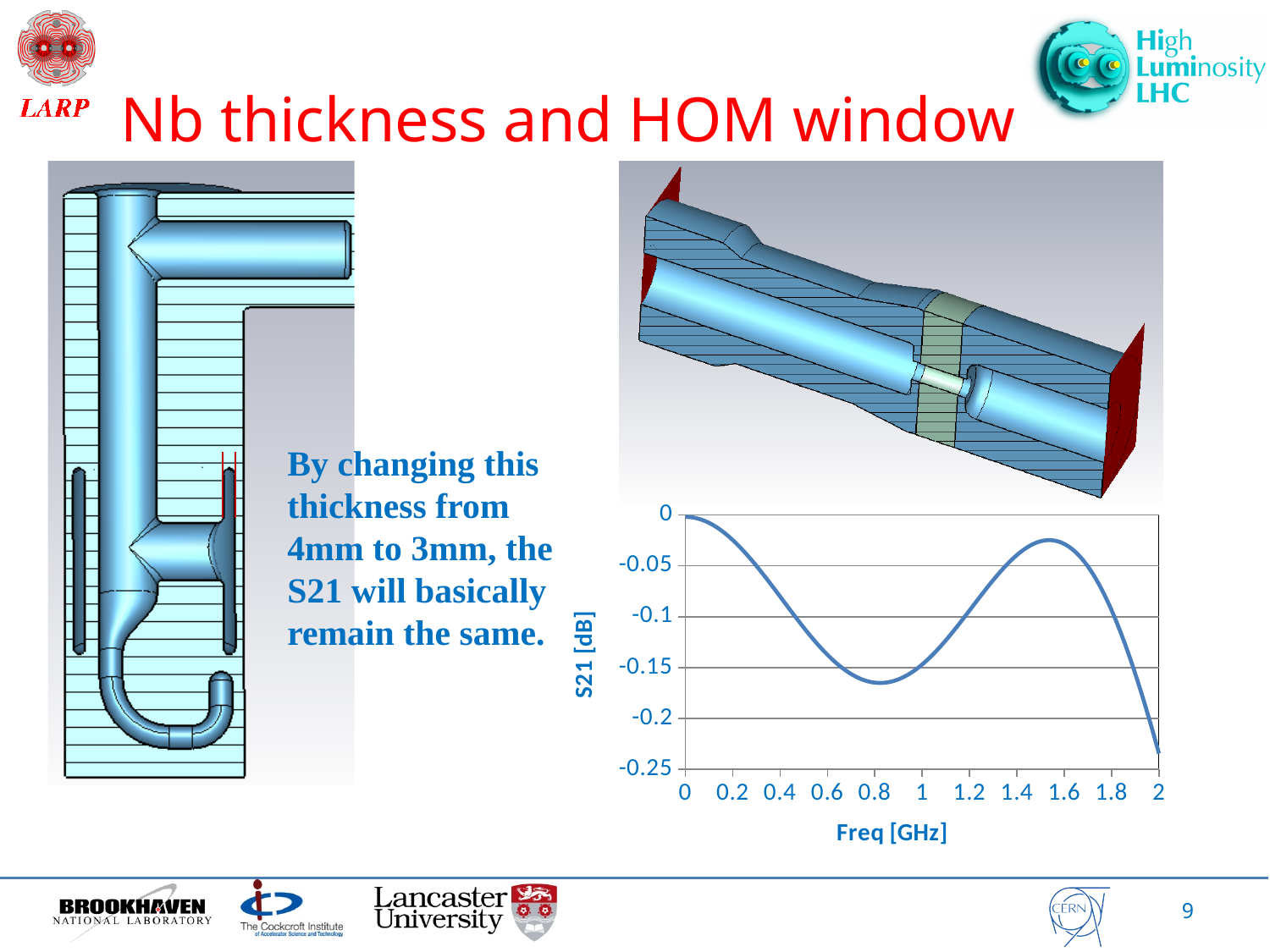
What kind of chart is shown on the slide? line chart Is the S21 value at 2 GHz greater or less than -0.2? less Is the S21 value at 1.2 GHz greater or less than -0.15? greater Does the S21 curve rise or fall between 0.8 and 1.6 GHz? rise Is the S21 value at 1.6 GHz greater or less than -0.05? greater What is the label of the x axis of the chart? Freq [GHz] What is the label of the y axis of the chart? S21 [dB] Which is larger, the S21 value at 0.8 GHz or at 1.6 GHz? 1.6 GHz Does the S21 curve rise or fall between 0 and 0.8 GHz? fall At which frequency shown on the x axis is S21 lowest? 2 GHz